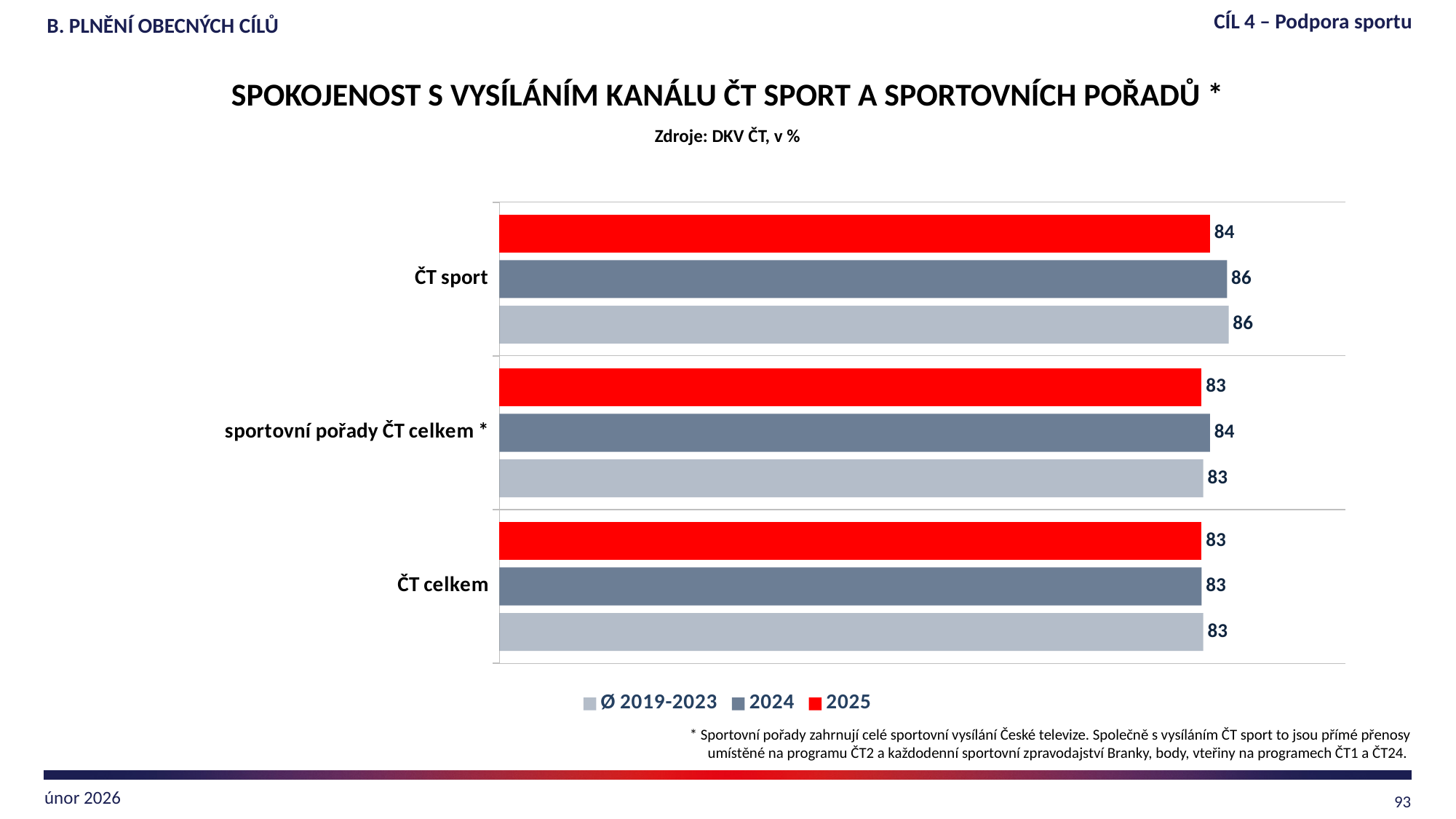
What is the 2024 value for ČT sport? 86 What kind of chart is shown on the slide? bar chart What is the 2024 value for sportovní pořady ČT celkem? 84 What is the Ø 2019-2023 value for sportovní pořady ČT celkem? 83 What is the 2025 value for ČT sport? 84 Which category has the highest 2025 value? ČT sport Is the 2024 value for ČT sport larger or smaller than the 2024 value for ČT celkem? larger What is the difference between the 2024 and 2025 values for ČT sport? 2 How many series does the legend list? 3 How many categories are shown on the chart? 3 What is the 2025 value for ČT celkem? 83 Which series is shown in red? 2025